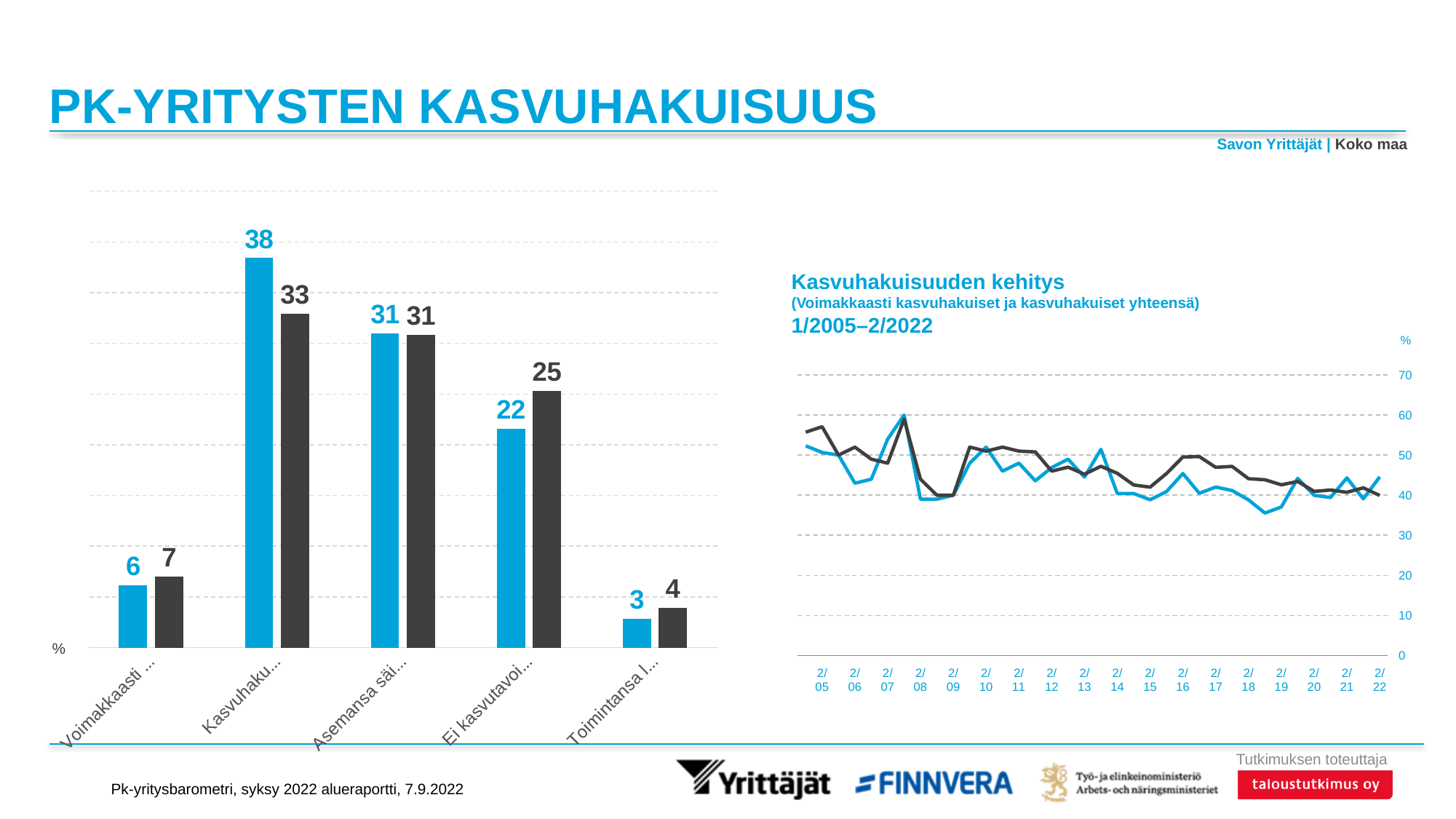
How many series does the legend at the top right of the slide list? 2 What kind of chart is the chart titled "Kasvuhakuisuuden kehitys"? line chart On the left bar chart, what is the value of the dark (Koko maa) bar for the fourth category, "Ei kasvutavoi..."? 25 On the "Kasvuhakuisuuden kehitys" chart, is the value of the dark line at 2/05 greater or less than 50? greater On the left bar chart, what is the value of the blue (Savon Yrittäjät) bar for the second category, "Kasvuhaku..."? 38 On the left bar chart, which category has the lowest dark (Koko maa) bar? Toimintansa l... On the left bar chart, what is the difference between the Savon Yrittäjät and Koko maa values for the second category, "Kasvuhaku..."? 5 On the left bar chart, for the fourth category "Ei kasvutavoi...", which is larger: the Savon Yrittäjät value or the Koko maa value? Koko maa On the left bar chart, which category has the highest blue (Savon Yrittäjät) bar? Kasvuhaku... How many categories are shown on the left bar chart? 5 On the "Kasvuhakuisuuden kehitys" chart, do the values generally rise or fall from 2/05 to 2/22? fall